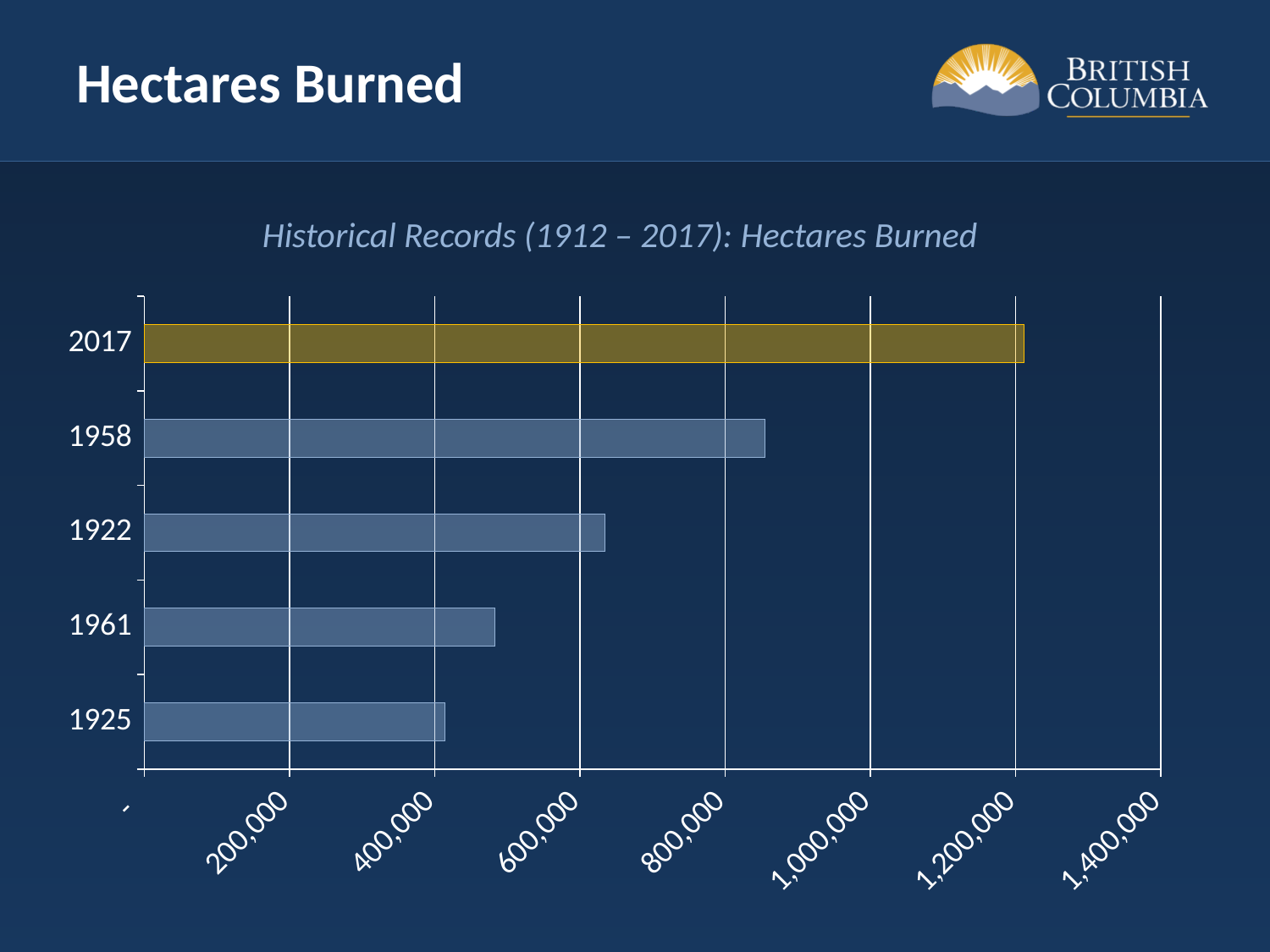
Which year had more hectares burned, 1961 or 1925? 1961 Which year's bar is highlighted in a different colour (gold) from the others? 2017 How many years are shown as categories in the chart? 5 Which year had more hectares burned, 1958 or 1922? 1958 Is the value for 1961 greater or less than 600,000? less Is the value for 2017 greater or less than 1,000,000? greater Which year has the lowest number of hectares burned among those shown? 1925 What is the title of the chart? Historical Records (1912 – 2017): Hectares Burned Which year has the highest number of hectares burned? 2017 Is the value for 1922 greater or less than 600,000? greater What type of chart is shown on the slide? bar chart